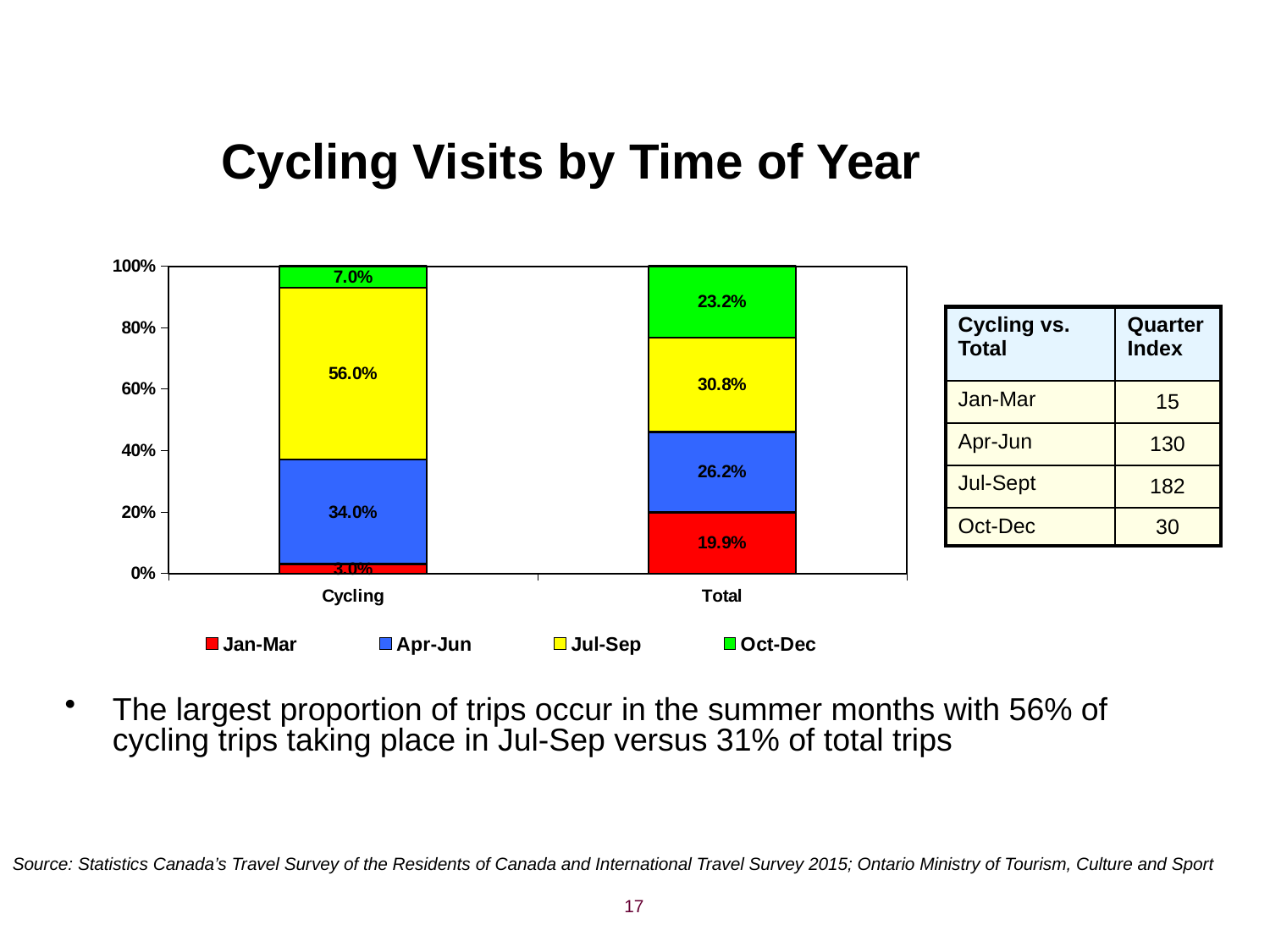
What is the Oct-Dec value for the Total bar? 23.2% What is the difference between the Jul-Sep share for Cycling and the Jul-Sep share for Total? 25.2% What is the Apr-Jun value for the Cycling bar? 34.0% What is the Jan-Mar value for the Total bar? 19.9% Which is larger: the Oct-Dec share for Cycling or the Oct-Dec share for Total? Total Which quarter has the largest share of the Cycling bar? Jul-Sep How many series does the legend list? 4 What percentage of cycling visits occur in Jul-Sep? 56.0% How many categories are shown on the x axis? 2 What colour represents Jul-Sep in the chart? Yellow What kind of chart is shown on the slide? Stacked bar chart Which quarter has the smallest share of the Total bar? Jan-Mar